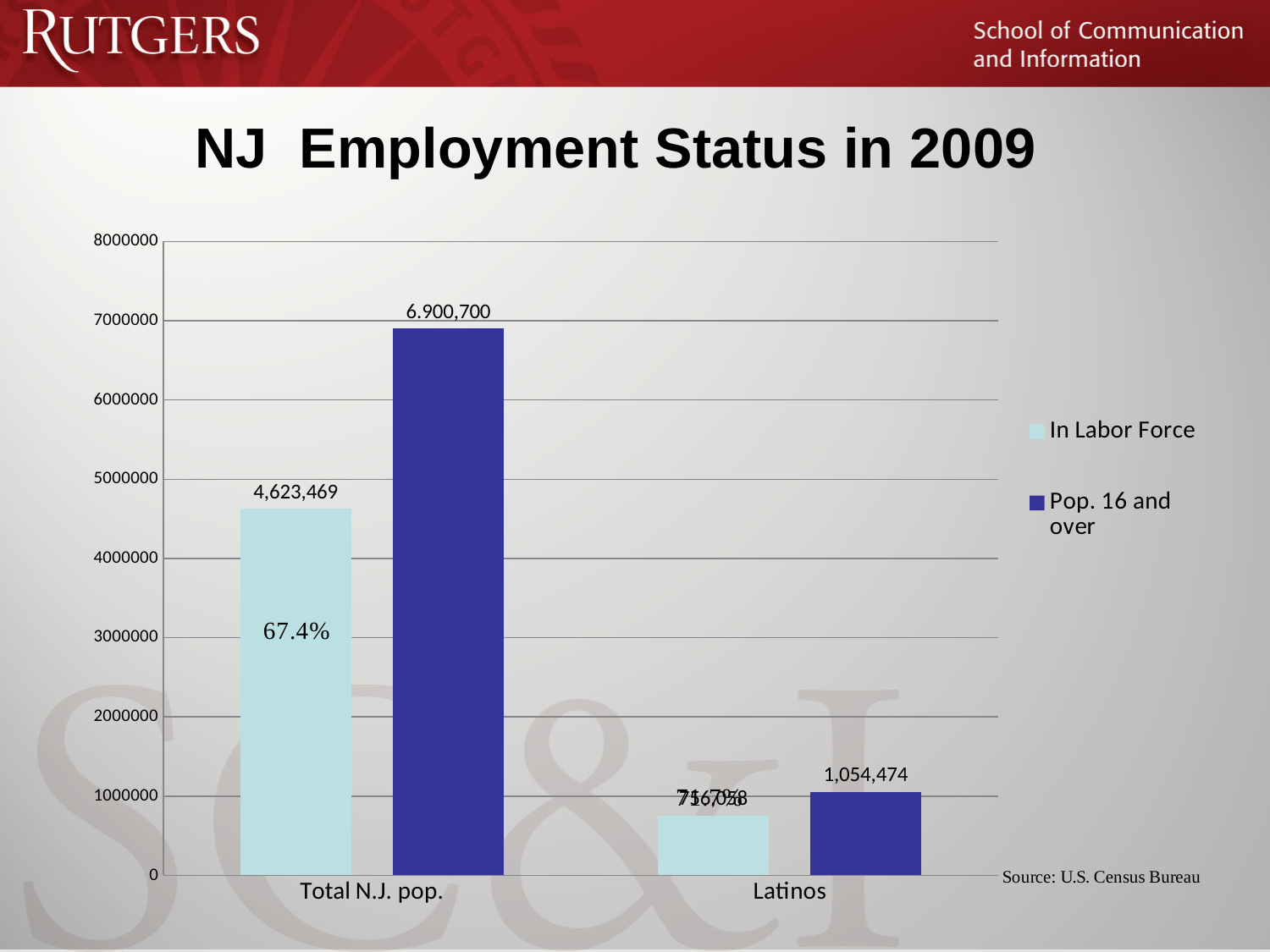
How many categories are shown on the x axis? 2 Is the value for In Labor Force for Latinos greater or less than 1000000? less What kind of chart is shown on the slide? bar chart What is the value for In Labor Force for Total N.J. pop.? 4,623,469 Which is larger: Pop. 16 and over for Total N.J. pop. or Pop. 16 and over for Latinos? Pop. 16 and over for Total N.J. pop. What is the difference between Pop. 16 and over and In Labor Force for Total N.J. pop.? 2,277,231 Which bar in the chart is the tallest? Pop. 16 and over for Total N.J. pop. What is the value for Pop. 16 and over for Latinos? 1,054,474 What is the value for Pop. 16 and over for Total N.J. pop.? 6,900,700 How many series does the legend list? 2 Which bar in the chart is the shortest? In Labor Force for Latinos What percentage is printed on the In Labor Force bar for Total N.J. pop.? 67.4%